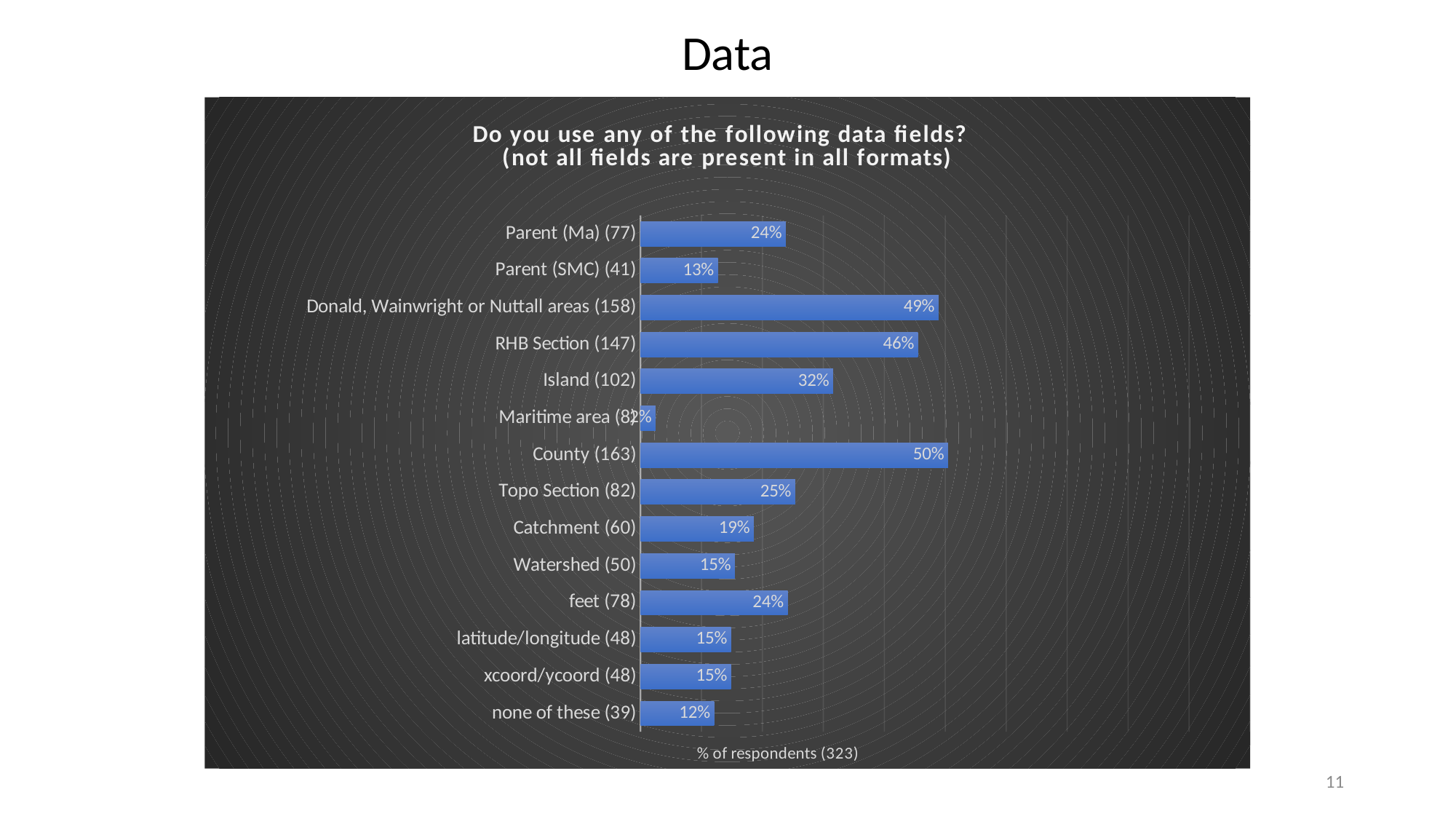
What type of chart is shown on the slide? Bar chart Which data field has the lowest percentage of respondents? Maritime area (8) How many data field categories are shown in the chart? 14 Which has a larger percentage, Island (102) or Watershed (50)? Island (102) What percentage of respondents use the County data field? 50% What is the label on the horizontal axis of the chart? % of respondents (323) Which has a larger percentage, Topo Section (82) or Catchment (60)? Topo Section (82) Which data field has the highest percentage of respondents? County (163) What is the value for 'none of these (39)'? 12% What is the difference in percentage between Donald, Wainwright or Nuttall areas and Parent (SMC)? 36% What is the value shown for RHB Section (147)? 46% What percentage is shown for Island (102)? 32%